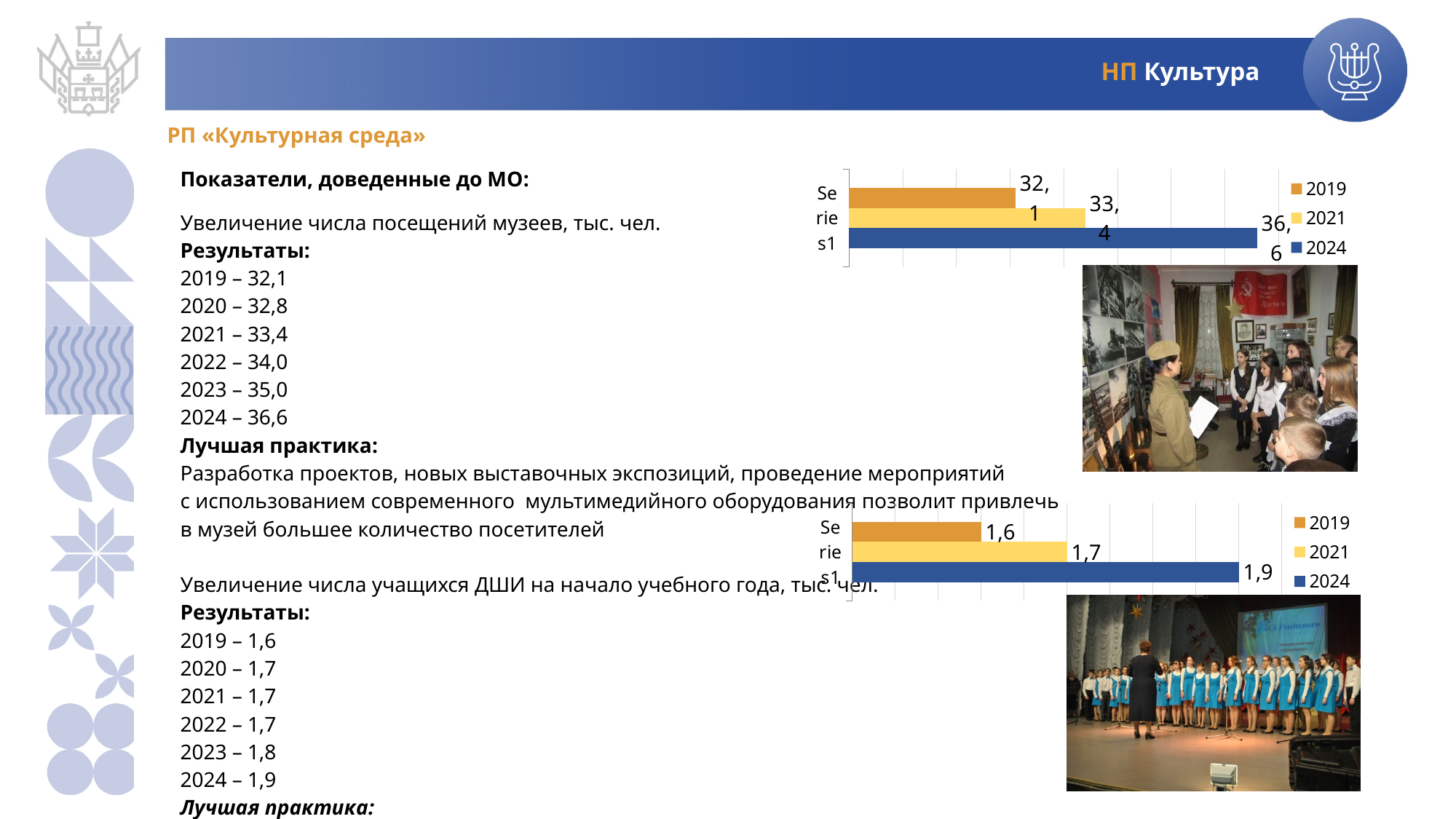
In the bottom chart, which is larger: the 2019 value or the 2024 value? 2024 In the bottom chart, what is the difference between the 2024 value and the 2019 value? 0,3 In the top chart, which series has the lowest value? 2019 In the top chart, what is the value for the 2024 series? 36,6 In the bottom chart, what is the value for the 2024 series? 1,9 In the bottom chart, which colour represents the 2024 series in the legend? blue In the top chart, how many series does the legend list? 3 In the bottom chart, what is the value for the 2021 series? 1,7 In the top chart, which series has the highest value? 2024 In the top chart, what is the difference between the 2024 value and the 2019 value? 4,5 In the top chart, what is the value for the 2019 series? 32,1 What type of chart is the top chart? bar chart